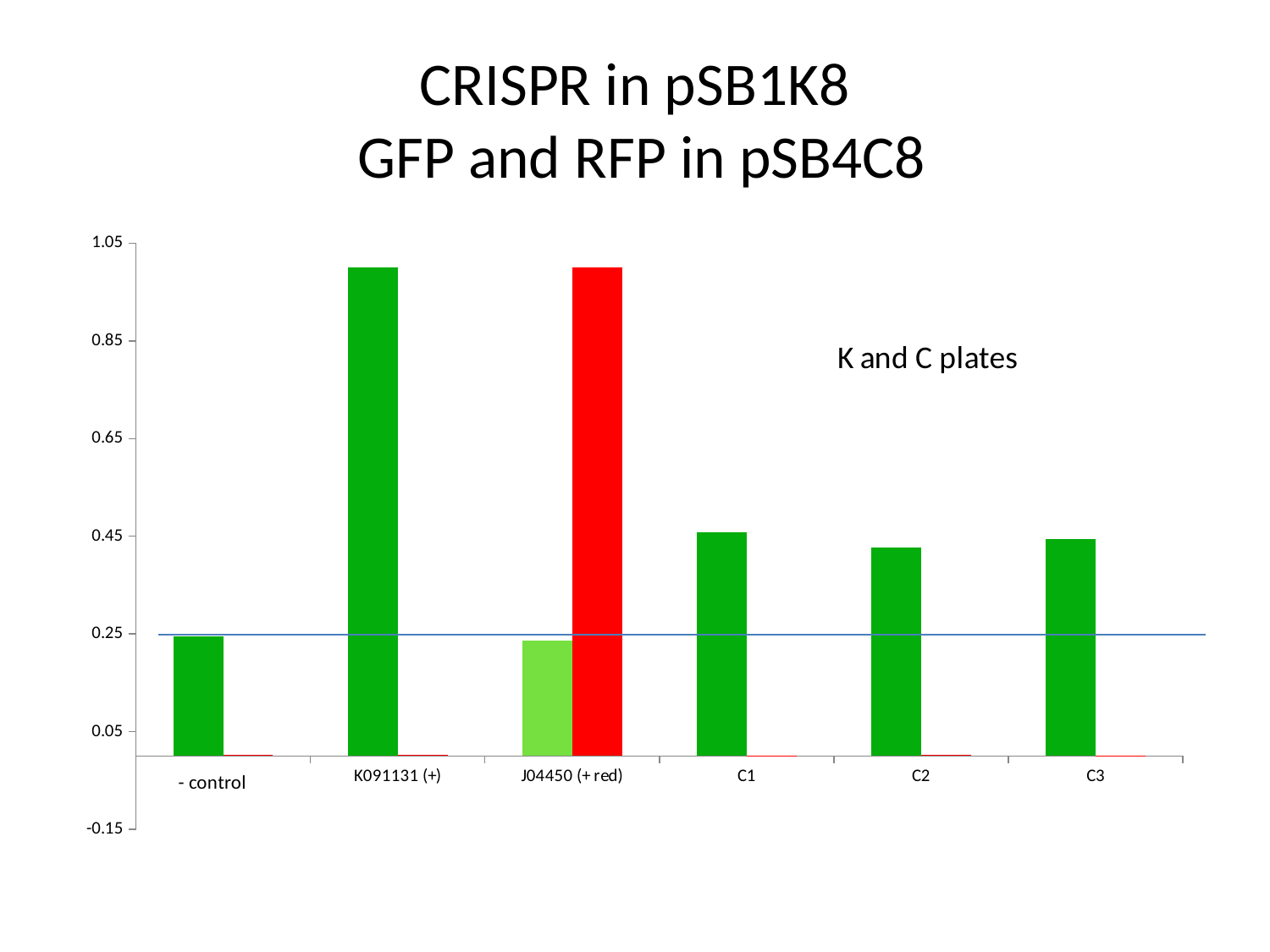
Is the red bar for J04450 (+ red) greater or less than 0.85? greater What kind of chart is shown on the slide? bar chart How many categories are shown on the x axis of the chart? 6 What colour is the tallest bar for J04450 (+ red)? red What is the title of the slide? CRISPR in pSB1K8 GFP and RFP in pSB4C8 Which has the taller green bar, C1 or - control? C1 Is the green bar for - control greater or less than 0.45? less Is the green bar for C1 greater or less than 0.25? greater Which has the taller green bar, K091131 (+) or C1? K091131 (+) Which category has the tallest green bar? K091131 (+)